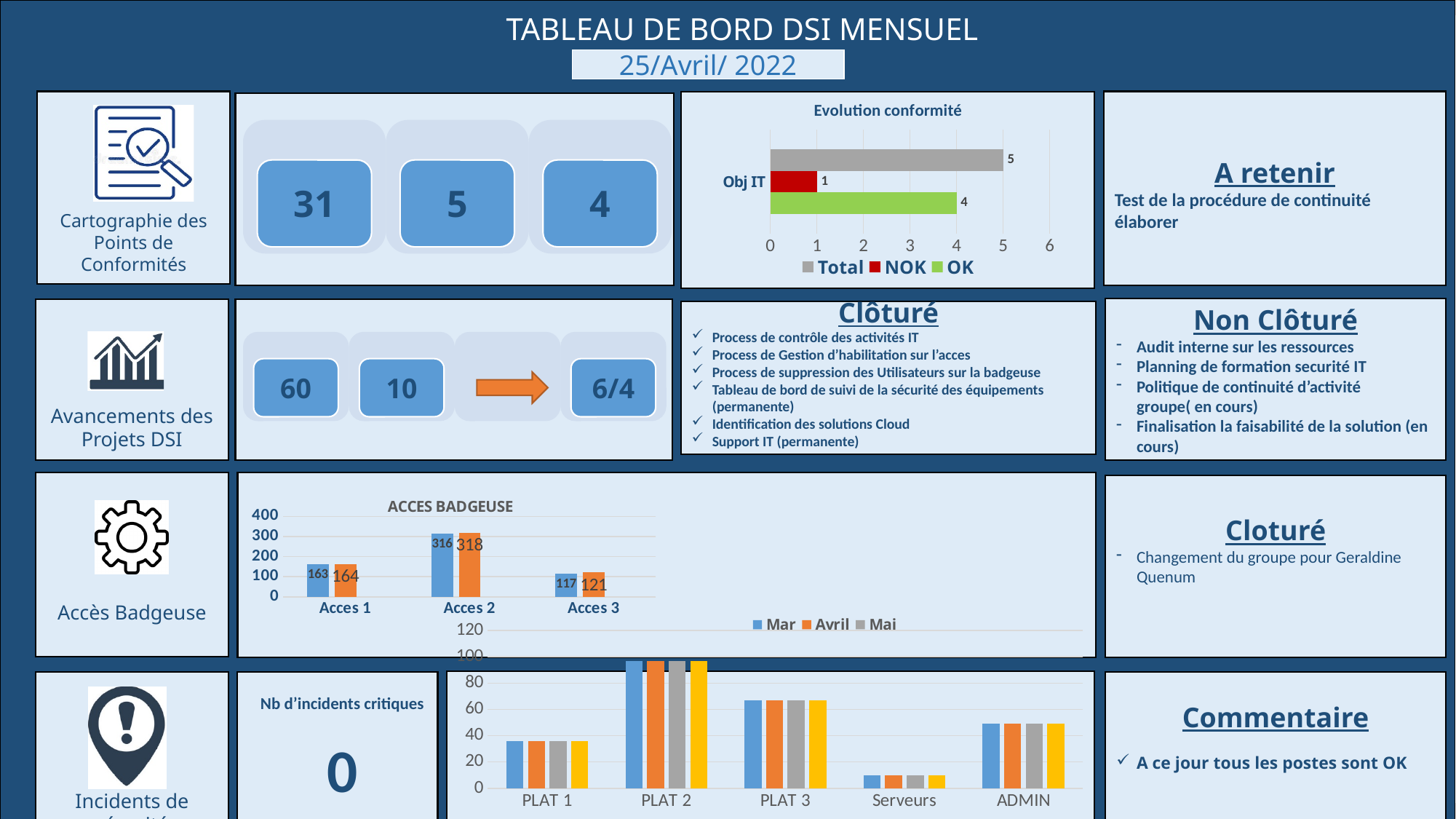
How many series does the legend of the 'Evolution conformité' chart list? 3 What kind of chart is 'Evolution conformité'? bar chart How many categories are shown on the x axis of the 'ACCES BADGEUSE' chart? 3 In the 'ACCES BADGEUSE' chart, which category has the highest values? Acces 2 In the 'Evolution conformité' chart, what is the difference between the OK and NOK values? 3 In the 'Evolution conformité' chart, what is the Total value for Obj IT? 5 In the bottom chart with PLAT 1, PLAT 2, PLAT 3, Serveurs and ADMIN, are the values for Serveurs greater or less than 20? less In the 'ACCES BADGEUSE' chart, what is the Mar value for Acces 3? 117 In the 'ACCES BADGEUSE' chart, what is the difference between the Avril and Mar values for Acces 1? 1 In the bottom chart with PLAT 1, PLAT 2, PLAT 3, Serveurs and ADMIN, which category has the highest bars? PLAT 2 In the 'ACCES BADGEUSE' chart, what is the Avril value for Acces 2? 318 In the 'Evolution conformité' chart, what is the NOK value for Obj IT? 1